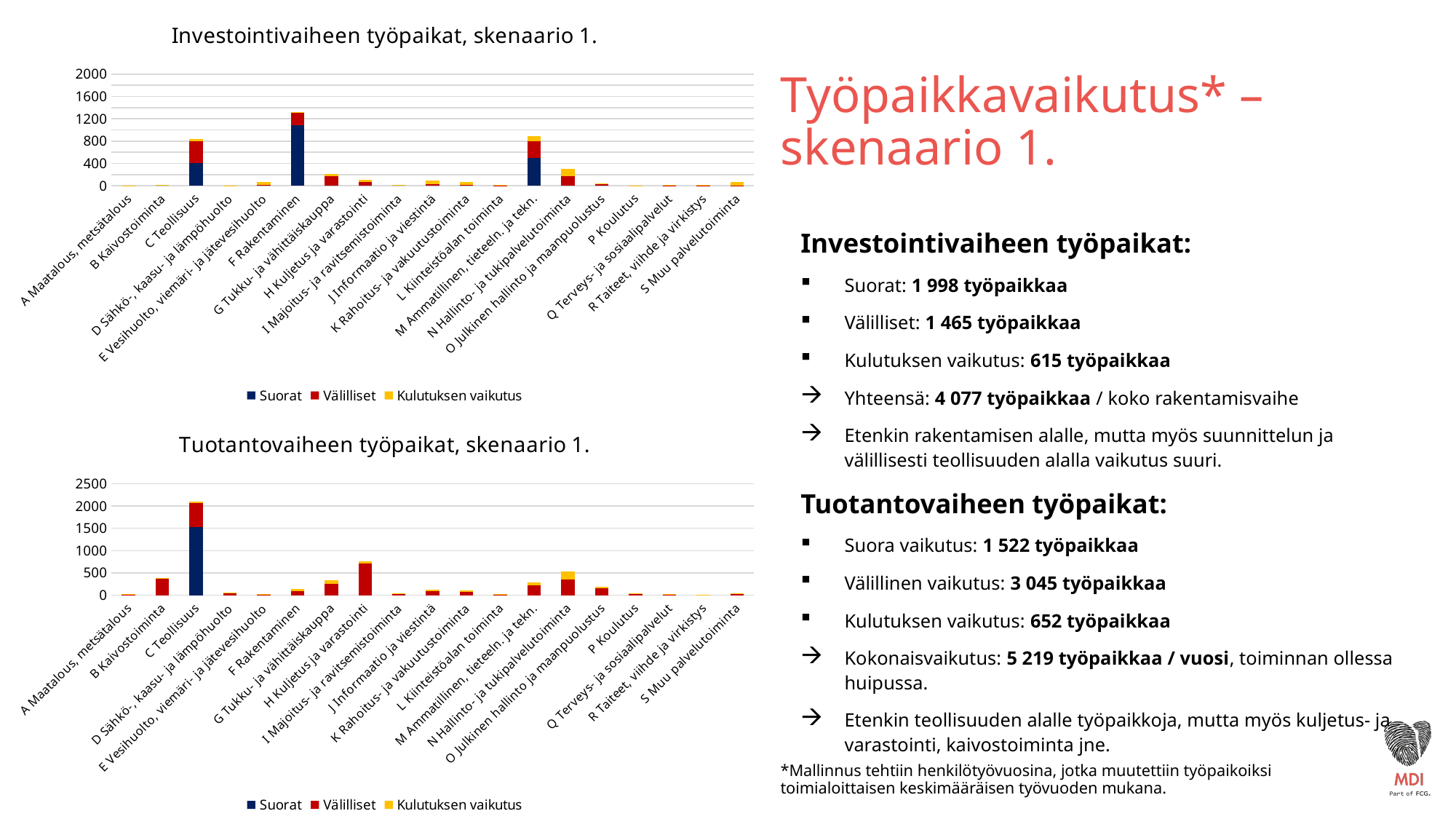
What kind of chart is the 'Investointivaiheen työpaikat, skenaario 1.' chart? Stacked bar chart In the 'Investointivaiheen työpaikat, skenaario 1.' chart, is the total stacked value for F Rakentaminen greater or less than 1200? greater How many series does the legend of the 'Tuotantovaiheen työpaikat, skenaario 1.' chart list? 3 In the 'Investointivaiheen työpaikat, skenaario 1.' chart, which category has the tallest stacked bar? F Rakentaminen What are the three legend entries of the 'Investointivaiheen työpaikat, skenaario 1.' chart? Suorat, Välilliset, Kulutuksen vaikutus In the 'Investointivaiheen työpaikat, skenaario 1.' chart, is the total stacked value for C Teollisuus greater or less than 400? greater In the 'Tuotantovaiheen työpaikat, skenaario 1.' chart, which category has the tallest stacked bar? C Teollisuus In the 'Tuotantovaiheen työpaikat, skenaario 1.' chart, is the total stacked value for I Majoitus- ja ravitsemistoiminta greater or less than 1000? less In the 'Investointivaiheen työpaikat, skenaario 1.' chart, which has the taller stacked bar: F Rakentaminen or C Teollisuus? F Rakentaminen In the 'Tuotantovaiheen työpaikat, skenaario 1.' chart, which has the taller stacked bar: C Teollisuus or I Majoitus- ja ravitsemistoiminta? C Teollisuus How many categories are shown on the x axis of the 'Investointivaiheen työpaikat, skenaario 1.' chart? 19